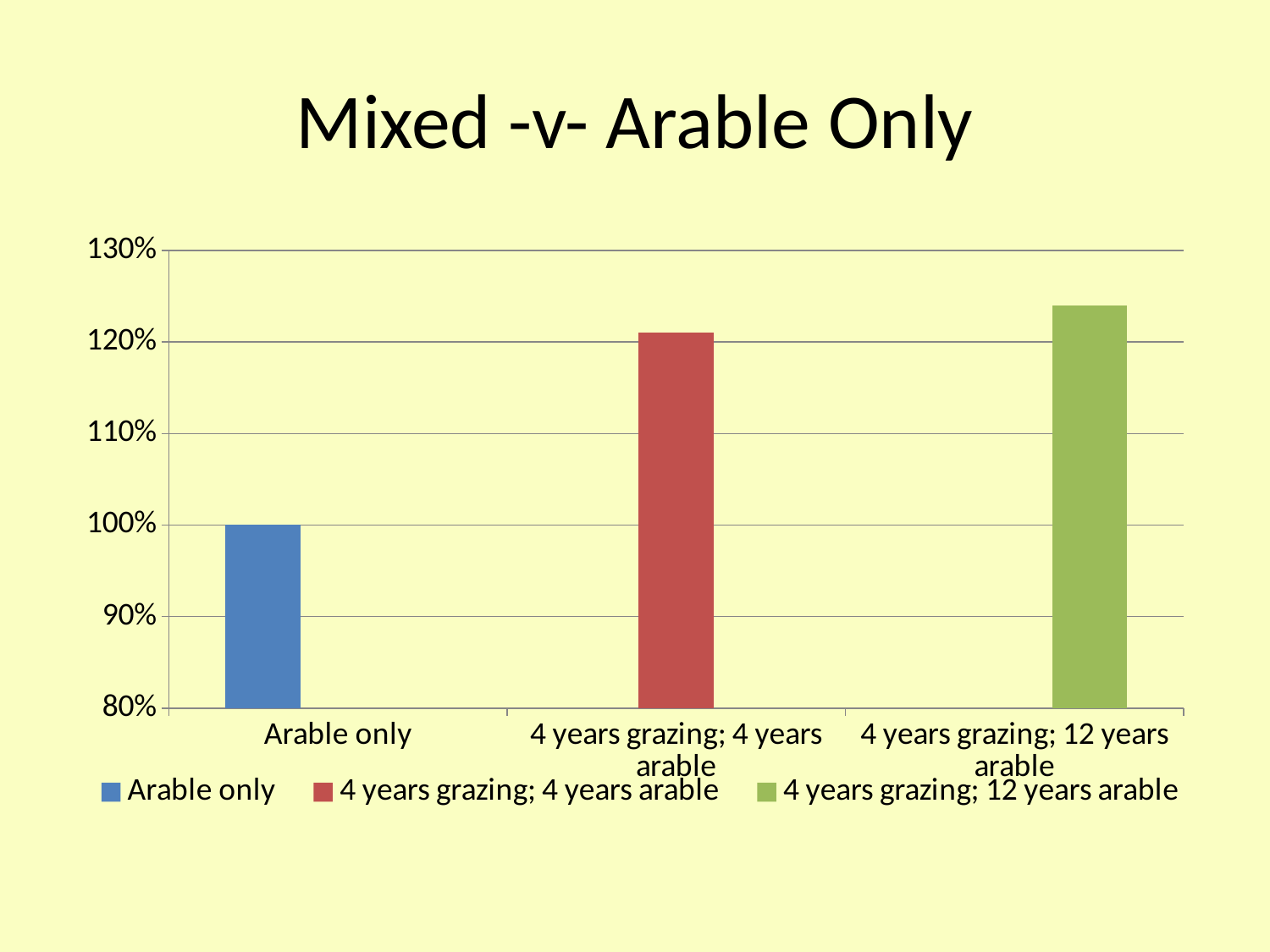
Which category has the lowest value? Arable only What is the title of the chart? Mixed -v- Arable Only How many entries does the legend list? 3 How many categories are plotted on the chart? 3 What is the value for Arable only? 100% What colour is the bar for Arable only? blue Which is larger, the value for Arable only or the value for 4 years grazing; 4 years arable? 4 years grazing; 4 years arable Is the value for 4 years grazing; 12 years arable greater or less than 130%? less Is the value for 4 years grazing; 12 years arable greater or less than 120%? greater Which category has the highest value? 4 years grazing; 12 years arable What kind of chart is shown on the slide? bar chart